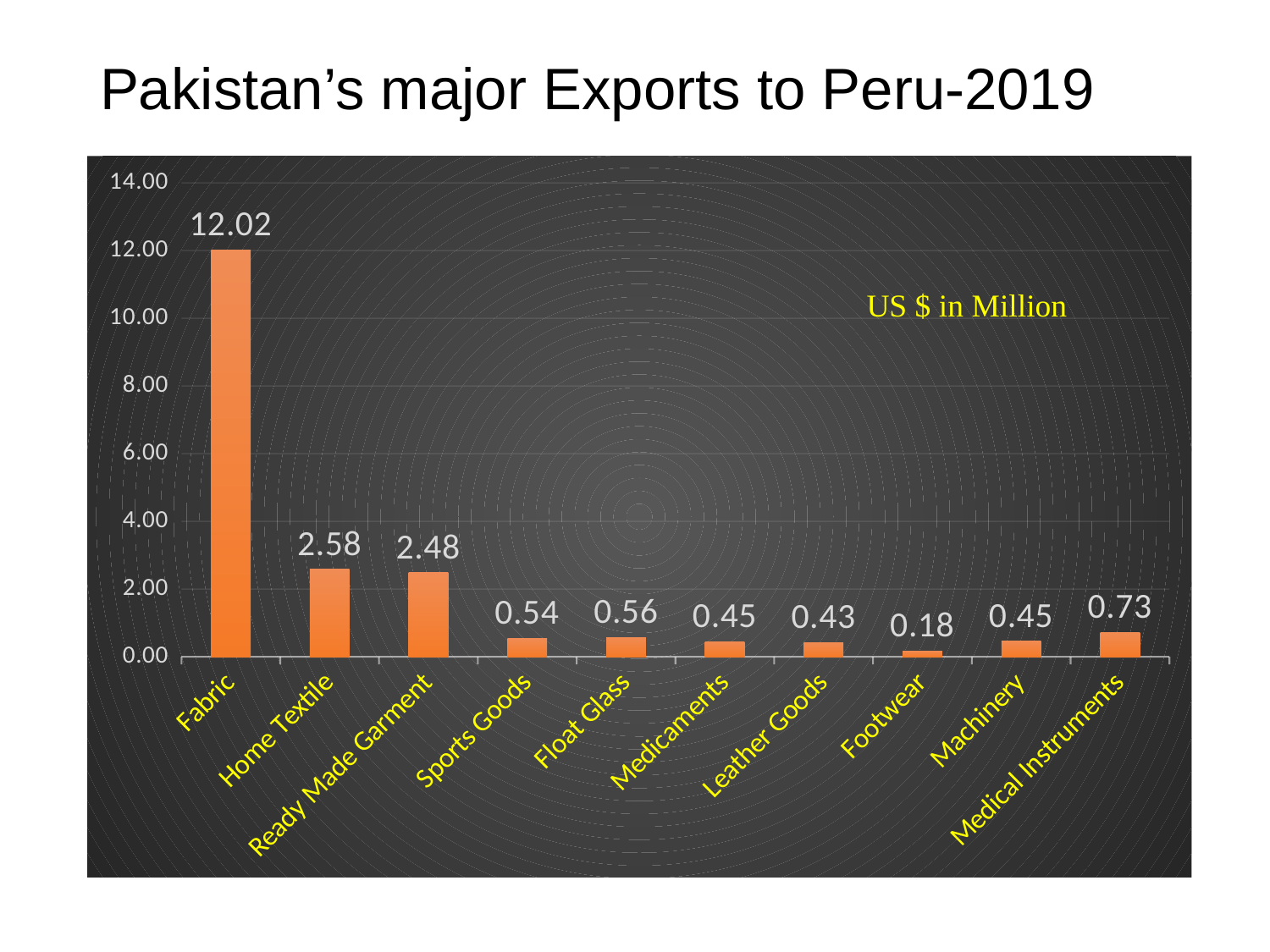
What unit is stated on the chart for the values? US $ in Million What kind of chart is shown on the slide? bar chart What is the export value for Medical Instruments? 0.73 How many categories are shown on the chart? 10 What is the export value for Home Textile? 2.58 Is the value for Fabric greater or less than 10.00? greater Which category has the highest export value? Fabric What is the difference between the export values for Home Textile and Ready Made Garment? 0.10 What is the export value for Fabric? 12.02 What is the export value for Footwear? 0.18 Which category has the lowest export value? Footwear Which has a larger export value, Float Glass or Sports Goods? Float Glass